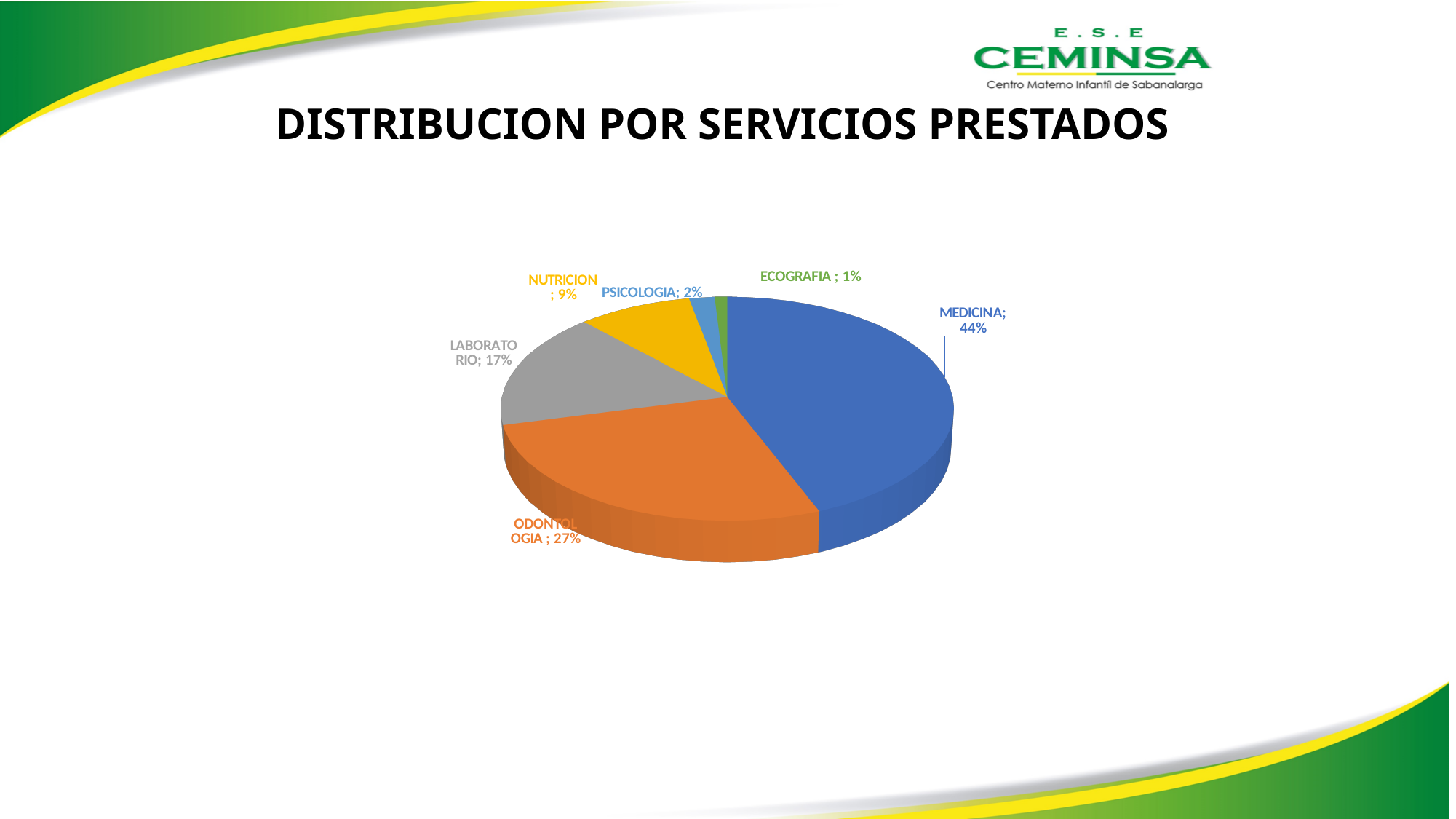
What is the value shown for PSICOLOGIA? 2% Which service has the largest share of the pie? MEDICINA What share of the pie does ODONTOLOGIA represent? 27% What is the value shown for NUTRICION? 9% What is the value shown for LABORATORIO? 17% How many slices does the pie chart have? 6 Which service has the smallest share of the pie? ECOGRAFIA Which has a larger share, LABORATORIO or NUTRICION? LABORATORIO What is the difference between the shares of MEDICINA and ODONTOLOGIA? 17% What kind of chart is shown on the slide? pie chart What is the title of the slide above the chart? DISTRIBUCION POR SERVICIOS PRESTADOS What share of the pie does MEDICINA represent? 44%